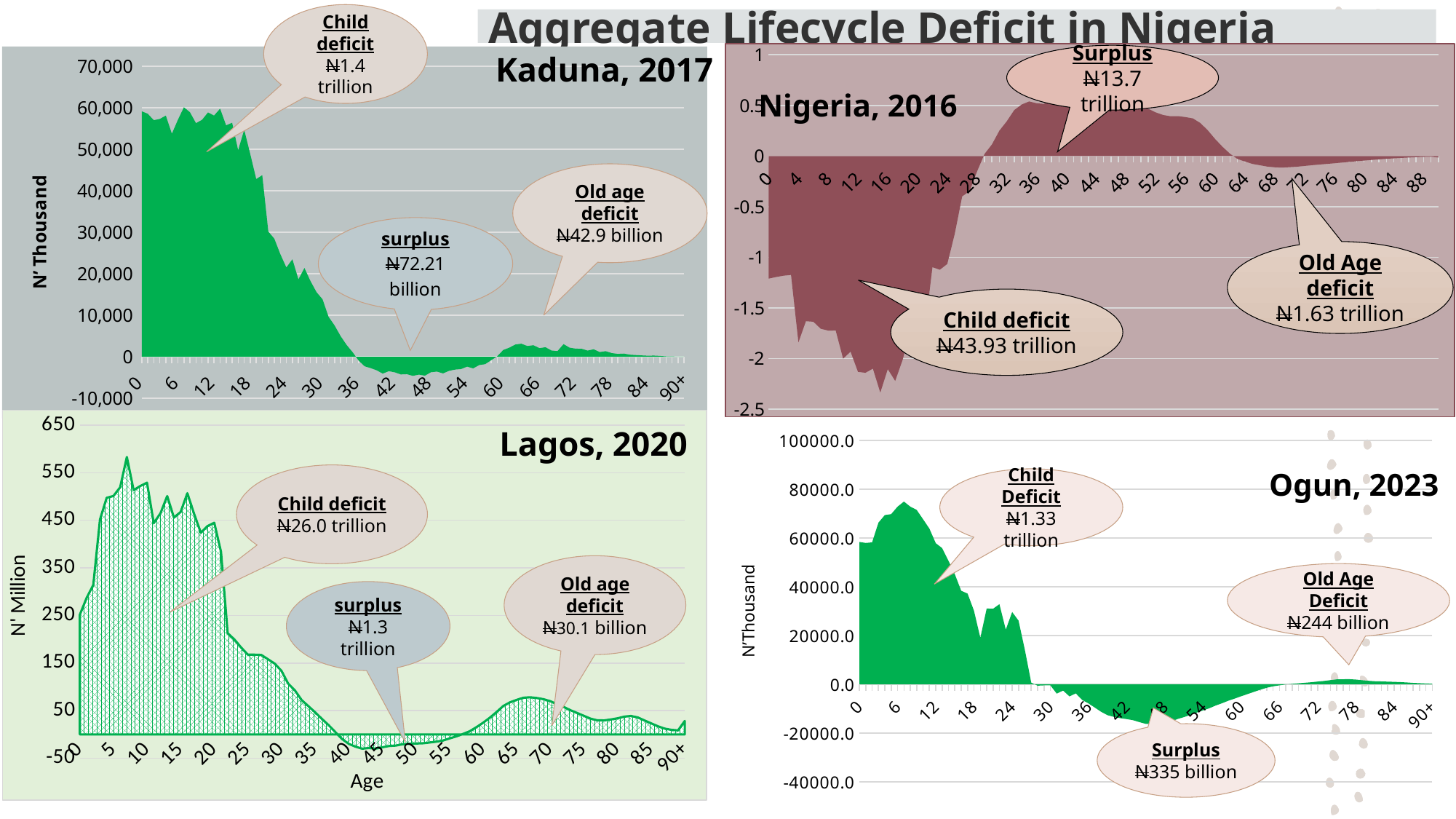
On the Lagos, 2020 chart, is the value at age 10 greater or less than 450? greater What kind of chart is the Kaduna, 2017 chart? Area chart On the Ogun, 2023 chart, what is the old age deficit shown in the callout? ₦244 billion On the Nigeria, 2016 chart, what is the old age deficit shown in the callout? ₦1.63 trillion On the Kaduna, 2017 chart, do the values rise or fall between age 12 and age 36? fall On the Nigeria, 2016 chart, what is the child deficit shown in the callout? ₦43.93 trillion On the Nigeria, 2016 chart, which is larger: the surplus or the old age deficit? Surplus On the Ogun, 2023 chart, is the value at age 6 greater or less than 60000.0? greater On the Lagos, 2020 chart, what is the surplus shown in the callout? ₦1.3 trillion On the Kaduna, 2017 chart, is the value at age 6 greater or less than 50,000? greater On the Kaduna, 2017 chart, what is the child deficit shown in the callout? ₦1.4 trillion On the Kaduna, 2017 chart, what is the surplus shown in the callout? ₦72.21 billion